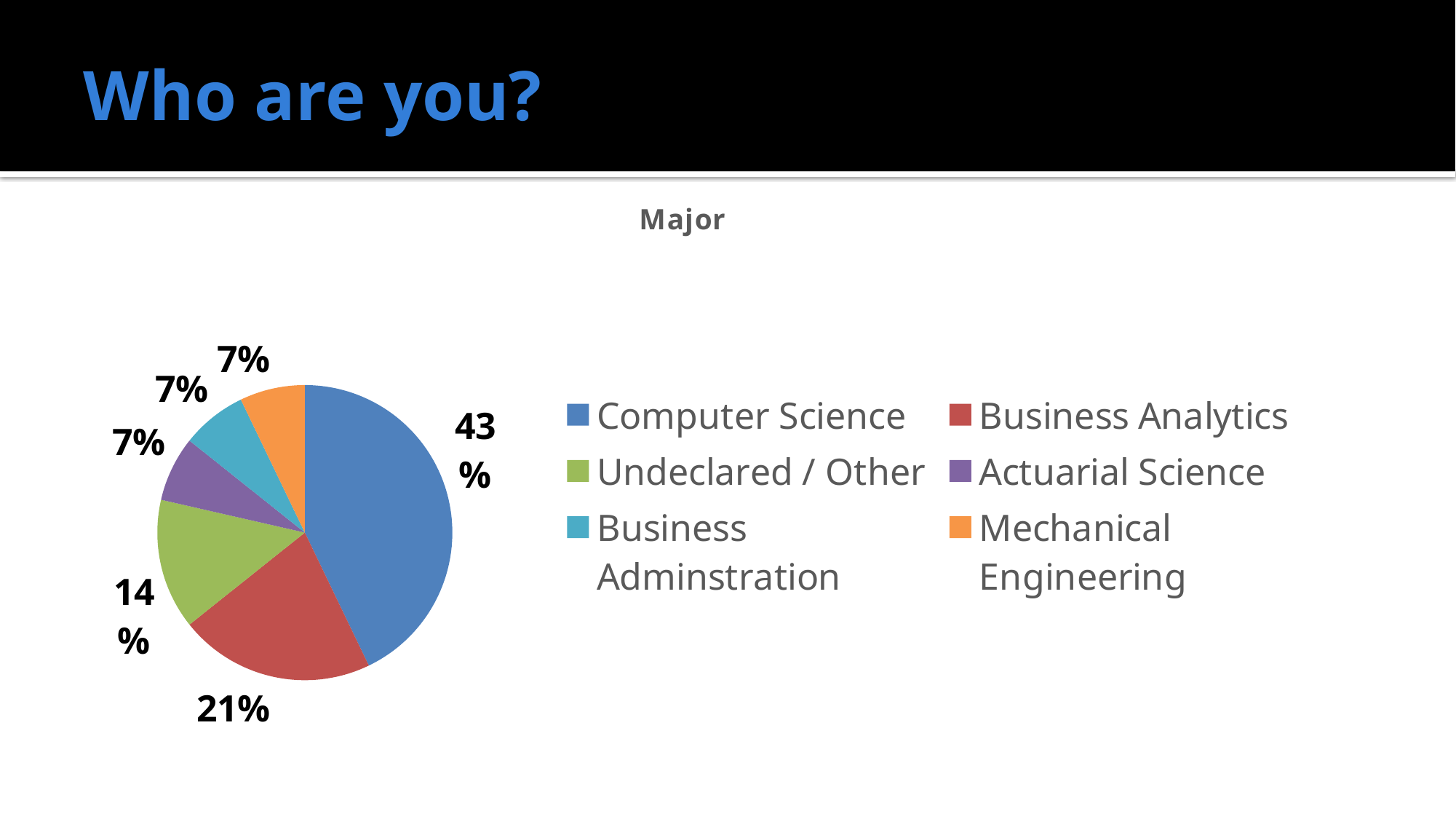
What percentage of the pie chart is Computer Science? 43% How many majors are shown in the pie chart? 6 What is the title of the chart? Major What percentage is shown for Actuarial Science? 7% What kind of chart is shown on the slide? Pie chart What percentage is shown for Undeclared / Other? 14% What share does Business Analytics have in the pie chart? 21% Which major has the largest slice of the pie chart? Computer Science What is the difference in percentage points between Computer Science and Business Analytics? 22 Which major is represented by the orange slice? Mechanical Engineering What is the difference in percentage points between Business Analytics and Undeclared / Other? 7 Which is larger, the share for Undeclared / Other or the share for Mechanical Engineering? Undeclared / Other